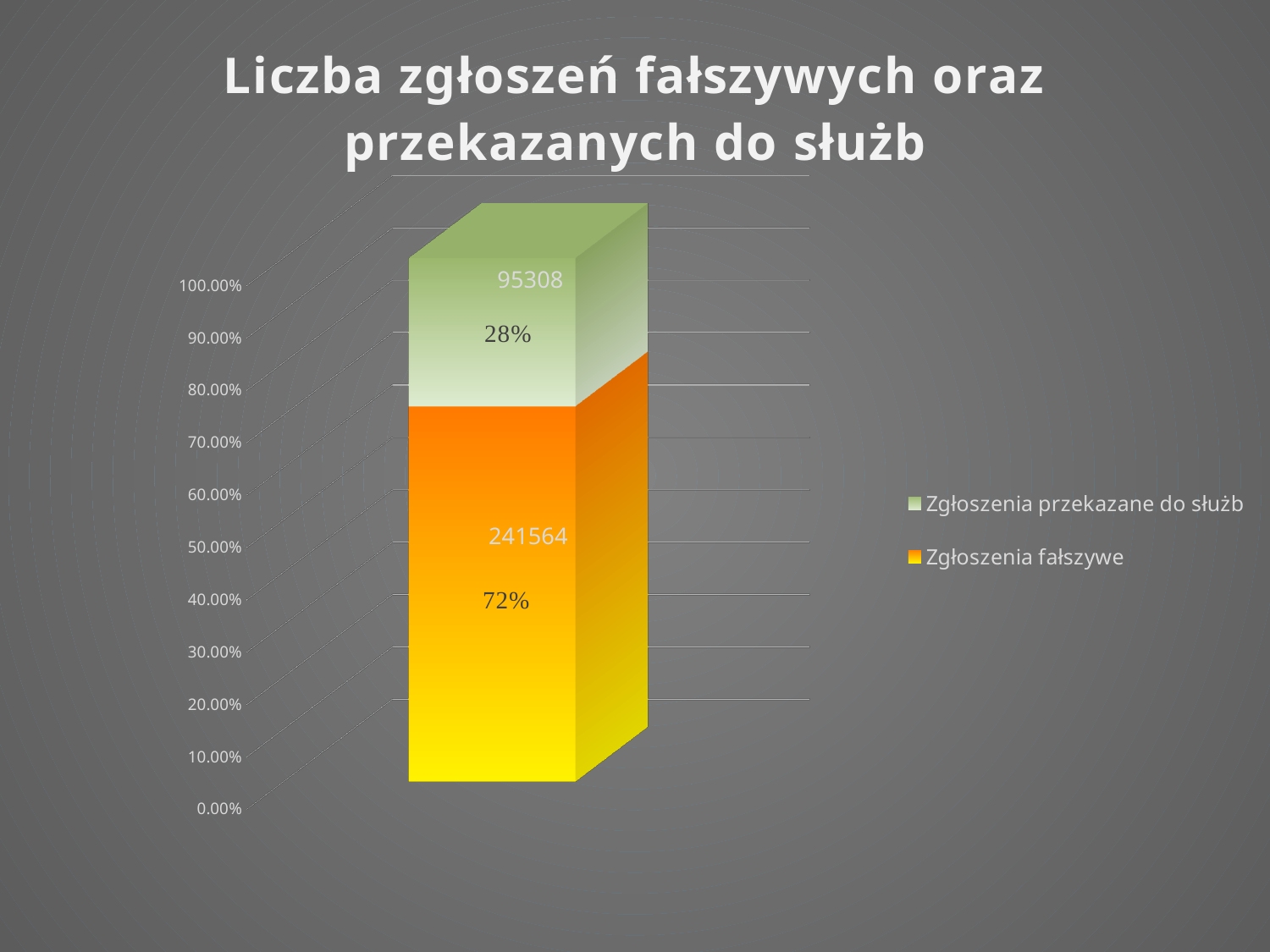
How many series does the legend list? 2 What is the total of the two values in the stacked bar? 336872 What is the value shown for Zgłoszenia przekazane do służb? 95308 What is the difference between the values for Zgłoszenia fałszywe and Zgłoszenia przekazane do służb? 146256 What percentage share is labelled for Zgłoszenia fałszywe? 72% Which colour represents Zgłoszenia przekazane do służb in the legend? Green What kind of chart is shown on the slide? Stacked bar chart Which series has the smallest value? Zgłoszenia przekazane do służb What is the value shown for Zgłoszenia fałszywe? 241564 What percentage share is labelled for Zgłoszenia przekazane do służb? 28% Which series has the larger value, Zgłoszenia fałszywe or Zgłoszenia przekazane do służb? Zgłoszenia fałszywe What is the title of the chart? Liczba zgłoszeń fałszywych oraz przekazanych do służb